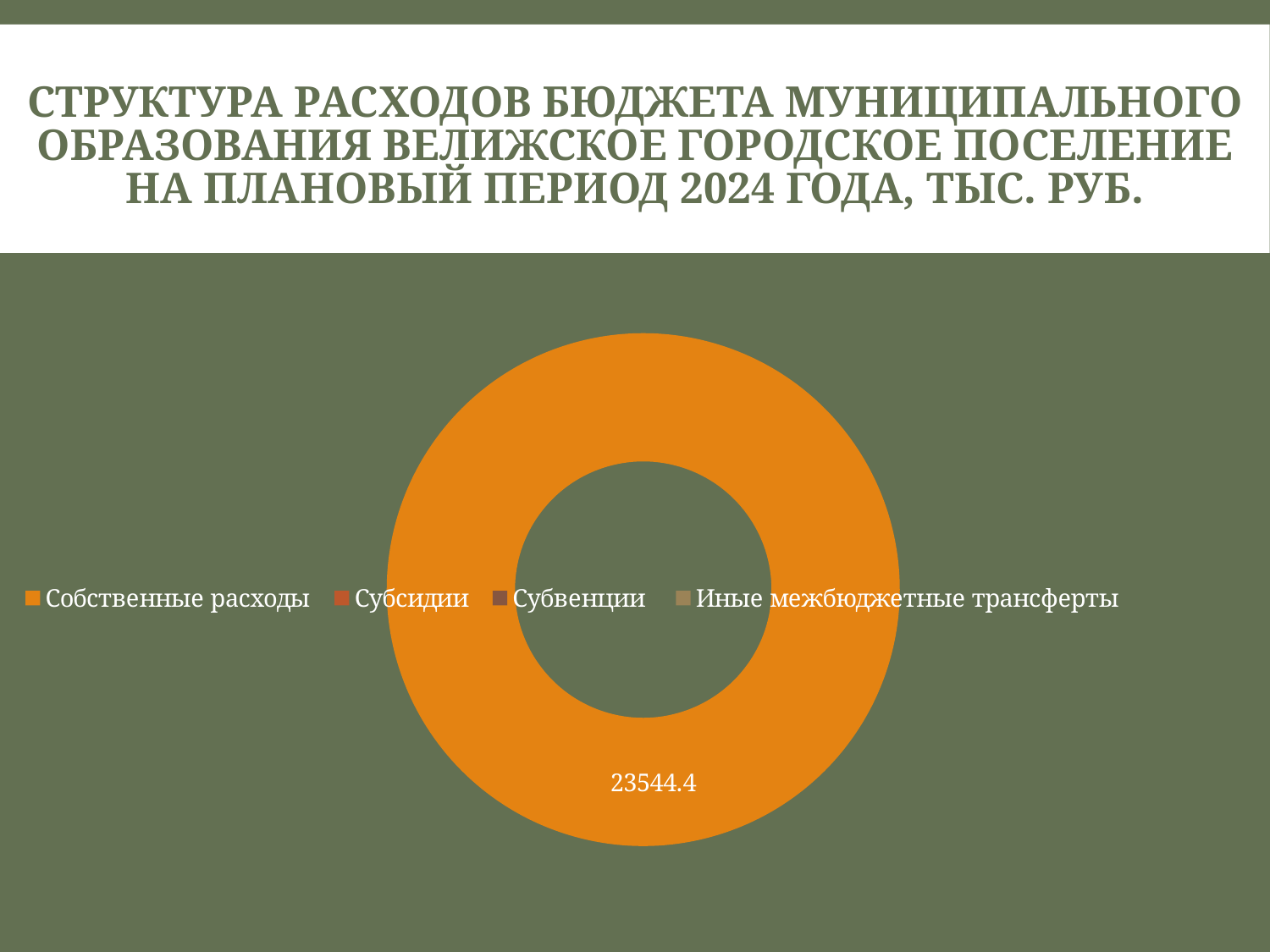
How many data labels are printed on the chart? 1 What kind of chart is shown on the slide? Doughnut (pie) chart Which category has the largest value on the chart? Собственные расходы In what units are the values on the chart expressed, according to the slide title? тыс. руб. What colour represents Собственные расходы in the chart? Orange Which legend entry is listed last? Иные межбюджетные трансферты Which category fills the entire ring of the doughnut chart? Собственные расходы What value is shown for Собственные расходы on the chart? 23544.4 How many entries does the chart legend list? 4